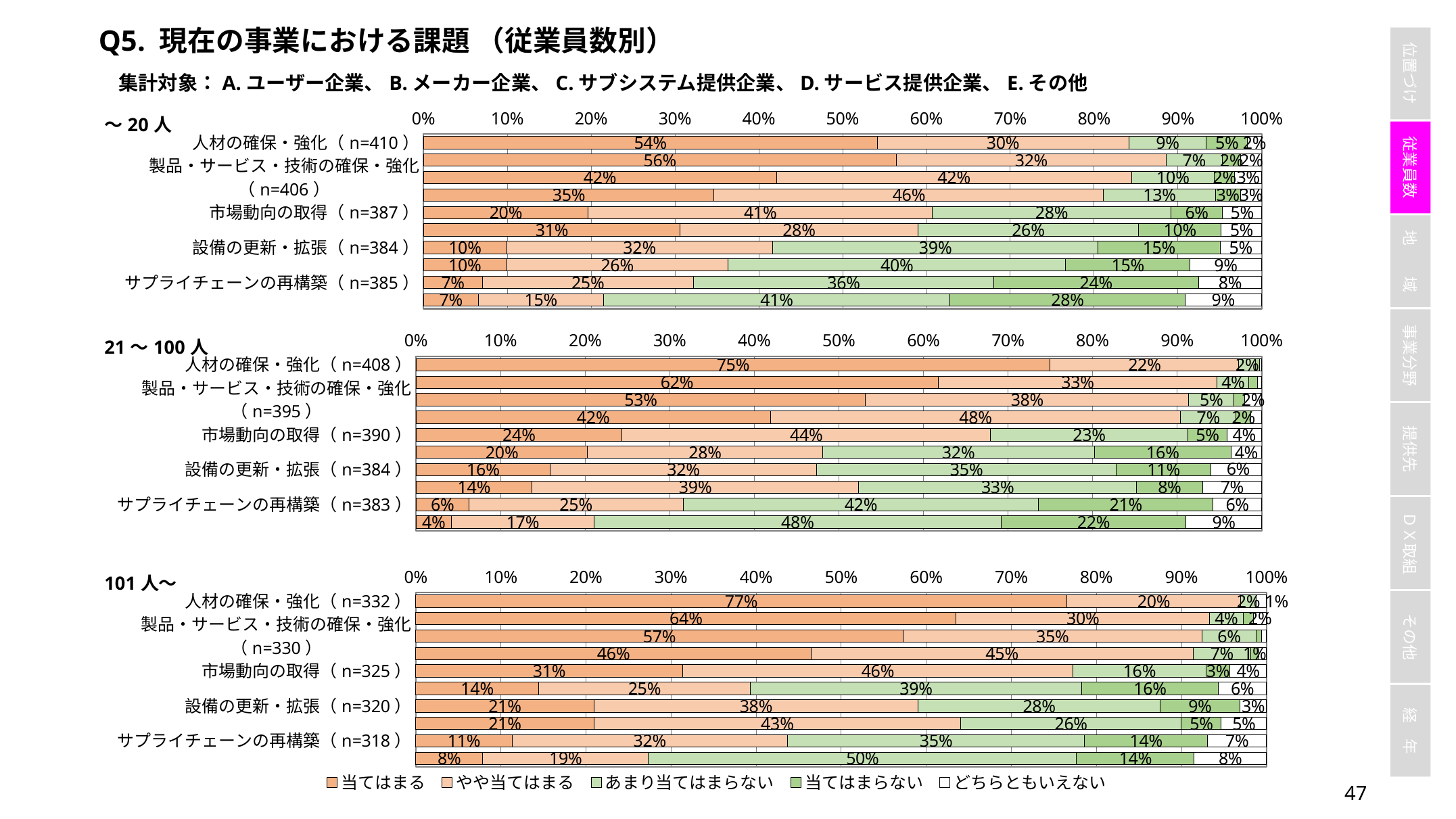
What is the first entry in the legend? 当てはまる In the 101人～ chart, what is the 当てはまる value for 人材の確保・強化? 77% In the 21～100人 chart, what is the やや当てはまる value for 人材の確保・強化? 22% How many series does the legend list? 5 What kind of chart is used on this slide? Stacked bar chart In the ～20人 chart, what is the やや当てはまる value for 人材の確保・強化? 30% How many bars are plotted in the 21～100人 chart? 10 In the 21～100人 chart, what is the 当てはまる value for 人材の確保・強化? 75% What is the difference between the 当てはまる value for 人材の確保・強化 in the 101人～ chart (77%) and in the ～20人 chart (54%)? 23 percentage points In the ～20人 chart, what is the 当てはまる value for 人材の確保・強化? 54% In the 101人～ chart, what is the やや当てはまる value for 人材の確保・強化? 20% Which is larger: the 当てはまる value for 人材の確保・強化 in the 101人～ chart or in the ～20人 chart? 101人～